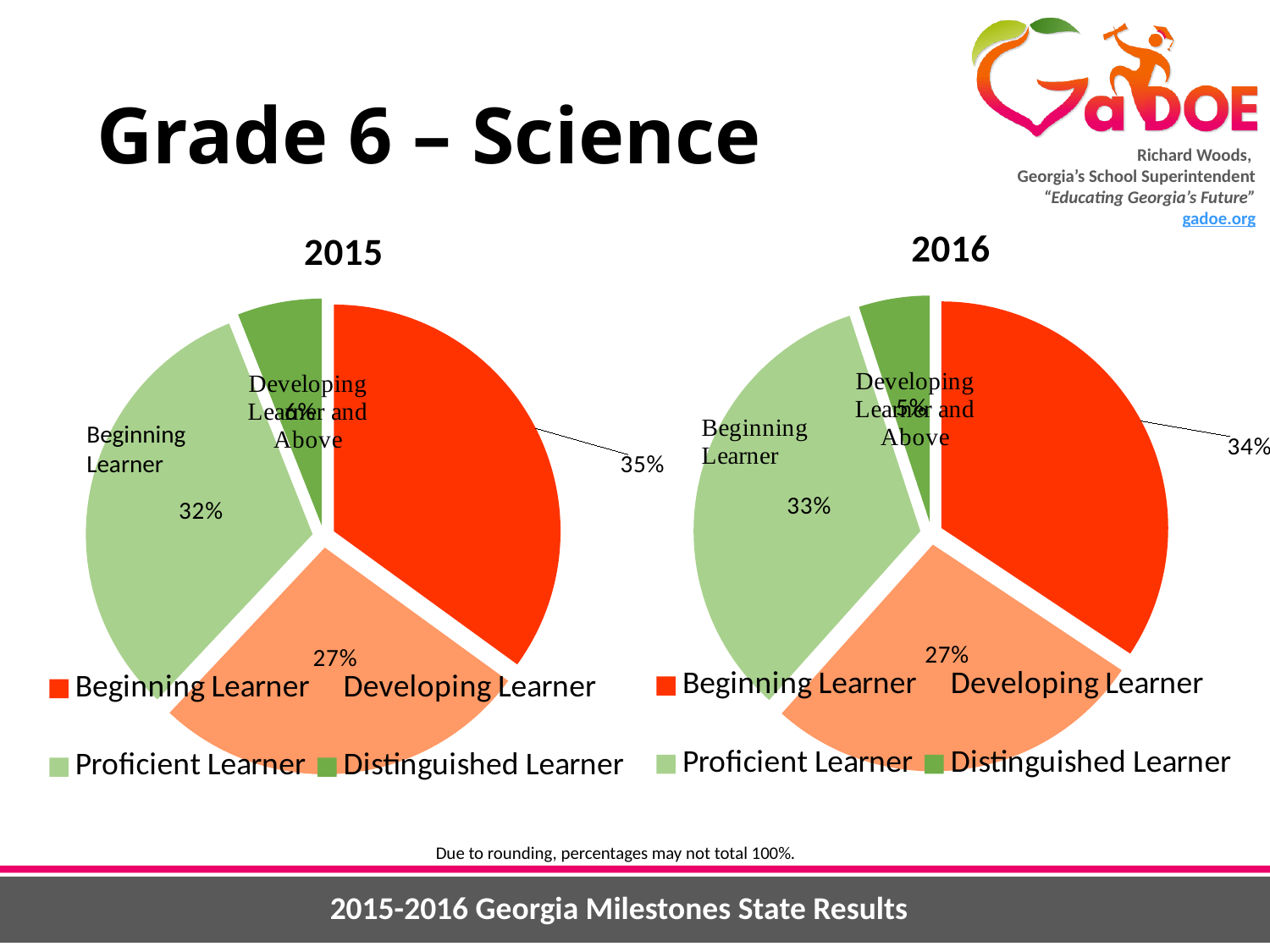
In the 2016 pie chart, what percentage is shown for Beginning Learner? 34% What type of chart is used to show the 2015 results? Pie chart How many slices does the 2016 pie chart have? 4 In the 2016 pie chart, what percentage is shown for Distinguished Learner? 5% How many entries does the legend of the 2015 chart list? 4 In the 2016 pie chart, what colour is the Beginning Learner slice? Red In the 2016 pie chart, which category has the smallest share? Distinguished Learner What is the difference between the Proficient Learner percentage in 2016 and in 2015? 1% In the 2015 pie chart, what percentage is shown for Proficient Learner? 32% In the 2015 pie chart, which category has the largest share? Beginning Learner In the 2015 pie chart, what percentage is shown for Beginning Learner? 35% In the 2015 pie chart, which is larger: Proficient Learner or Developing Learner? Proficient Learner